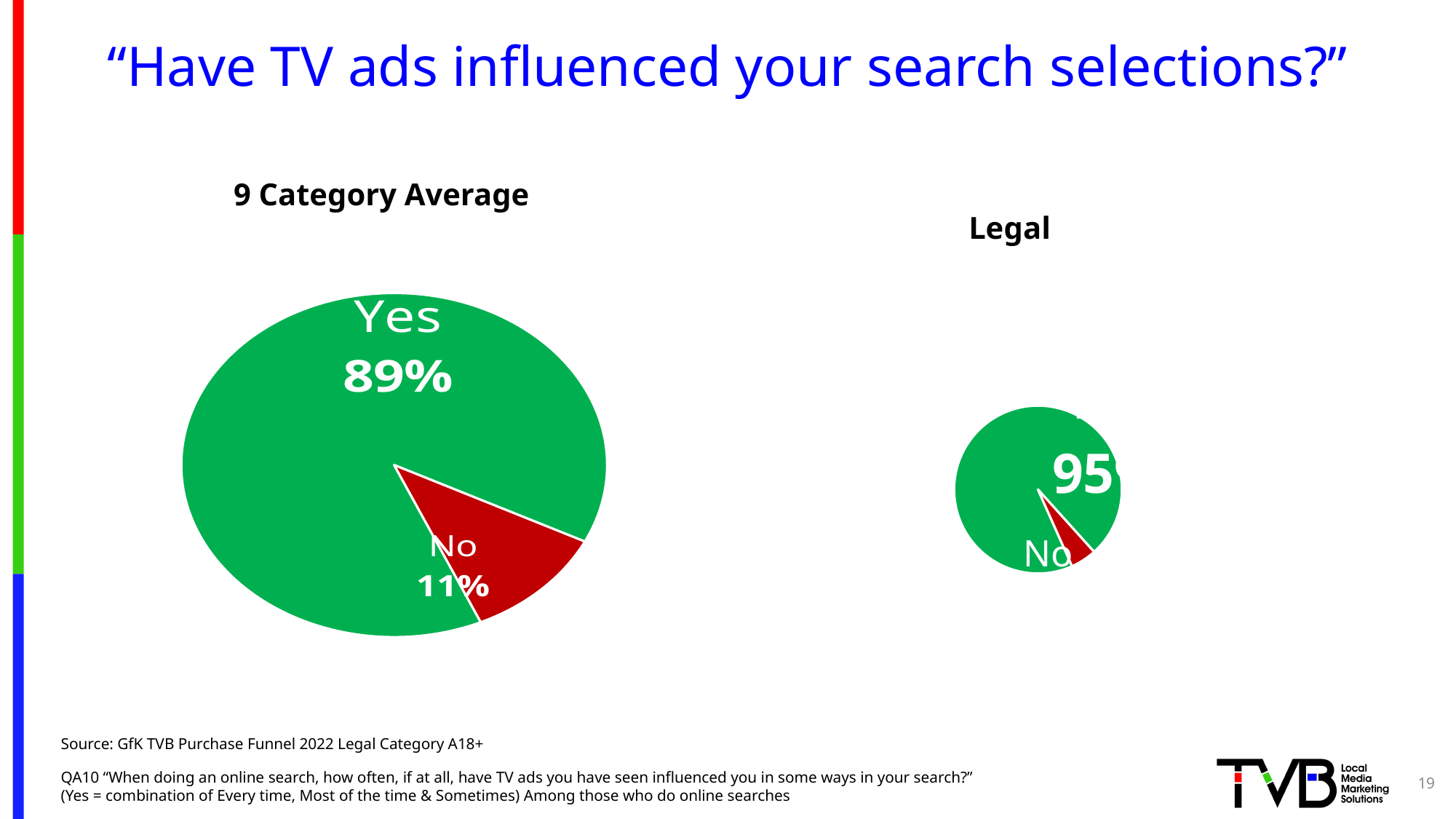
In the 9 Category Average chart, what colour is the Yes slice? Green How many slices does the 9 Category Average pie chart have? 2 In the 9 Category Average chart, what percentage answered Yes? 89% In the 9 Category Average chart, which slice is the smallest? No What kind of chart is the Legal chart? Pie chart What kind of chart is the 9 Category Average chart? Pie chart What is the title of the chart on the right side of the slide? Legal In the 9 Category Average chart, which is larger, Yes or No? Yes In the 9 Category Average chart, what percentage answered No? 11% In the 9 Category Average chart, what is the difference between the Yes and No percentages? 78% In the 9 Category Average chart, which slice is the largest? Yes In the Legal chart, is the No slice larger or smaller than the other slice? Smaller